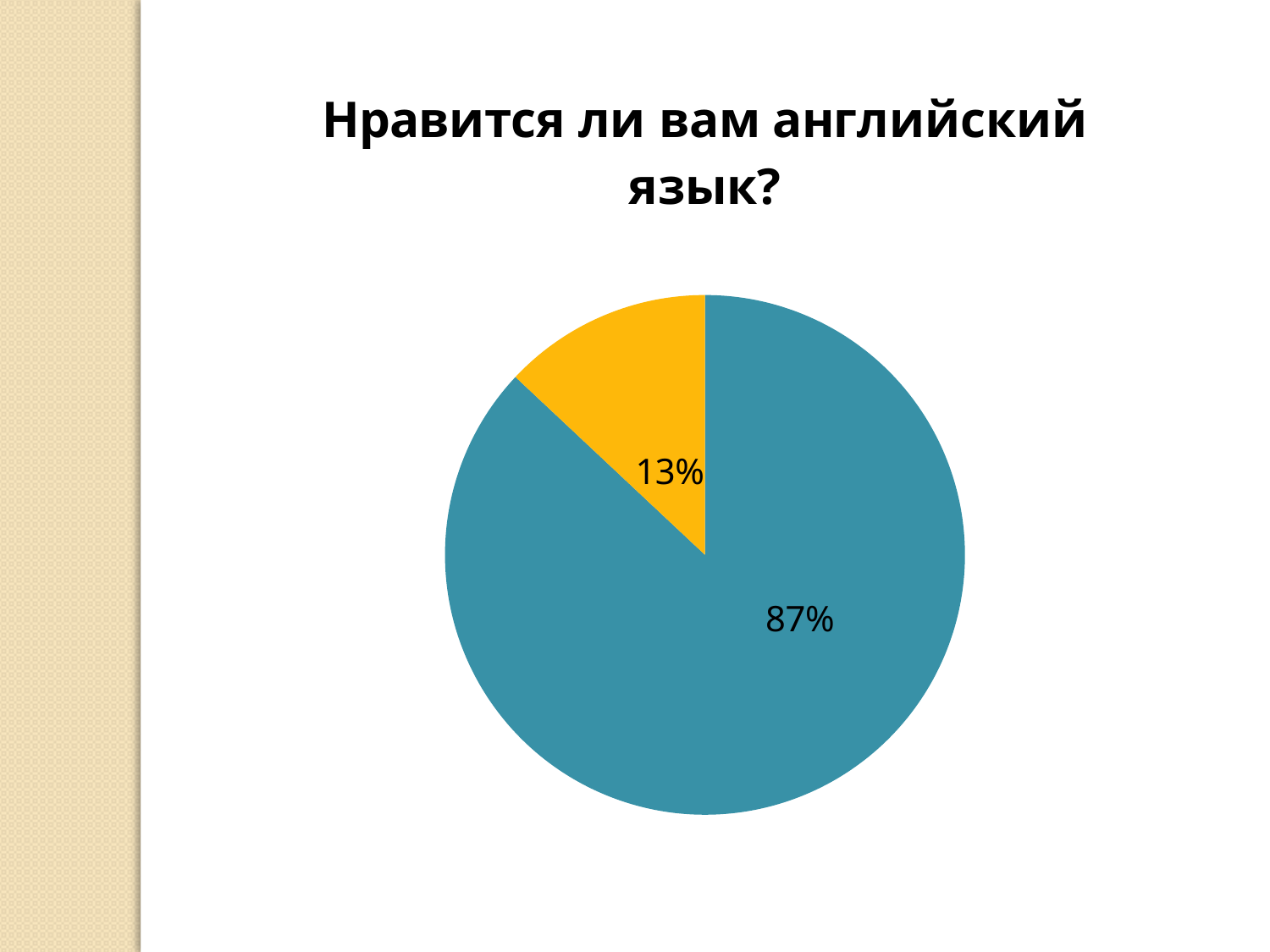
Which slice of the pie chart is the smallest? the orange slice (13%) Is the value of the blue slice greater or less than 50%? greater What is the title of the chart? Нравится ли вам английский язык? What percentage is shown on the orange slice of the pie chart? 13% Which slice is larger, the blue one or the orange one? the blue one What percentage is shown on the blue slice of the pie chart? 87% What is the difference in percentage points between the blue slice and the orange slice? 74 Which slice of the pie chart is the largest? the blue slice (87%) What colour is the largest slice of the pie chart? blue What share of the pie does the orange slice represent? 13% What kind of chart is shown on the slide? pie chart How many slices does the pie chart have? 2